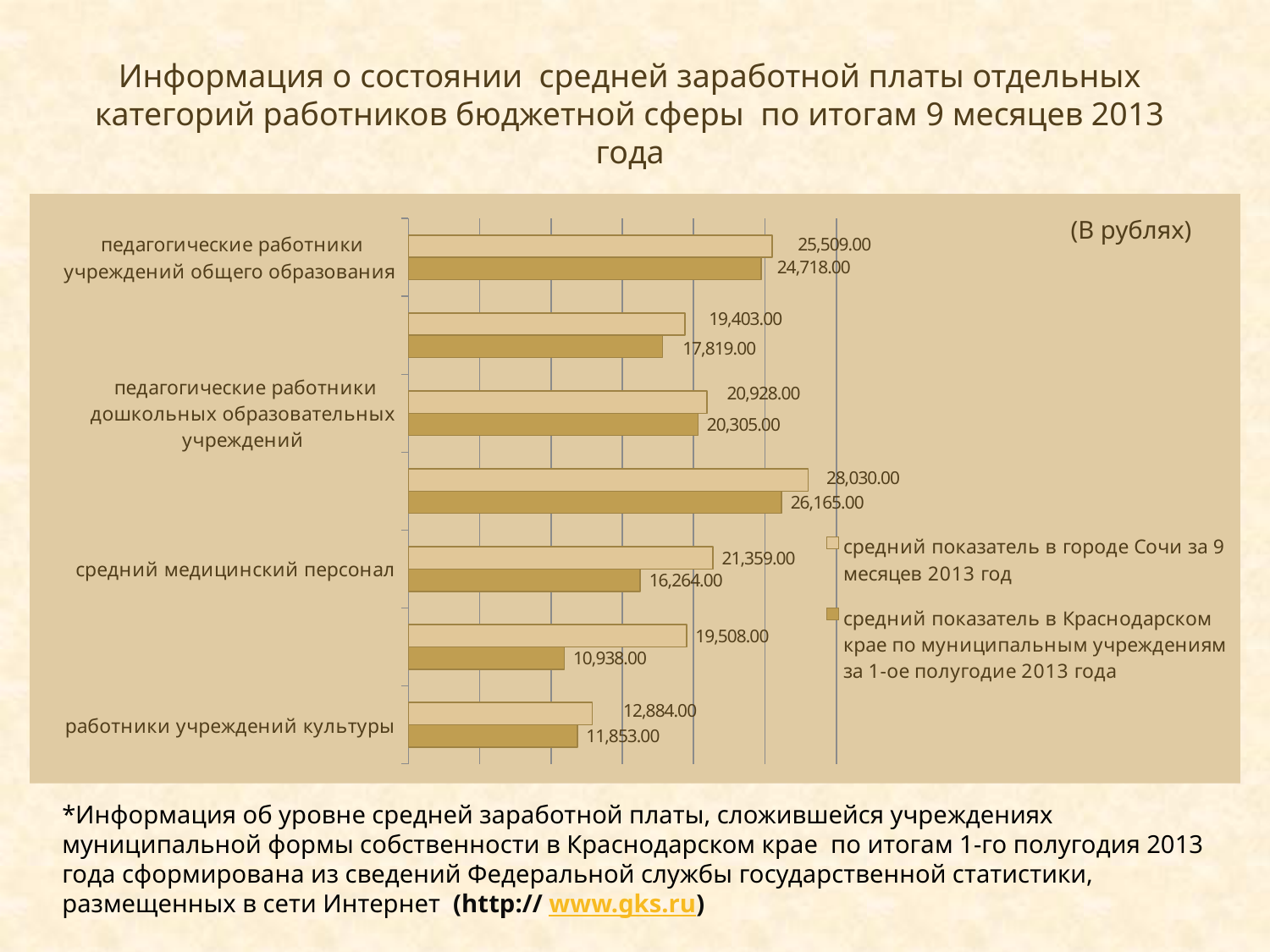
What is the average salary for педагогические работники учреждений общего образования in Sochi for 9 months of 2013? 25,509.00 How many series does the legend list? 2 Which labelled category has the lowest value in the Sochi series? работники учреждений культуры What is the value for педагогические работники дошкольных образовательных учреждений in the Краснодарский край series? 20,305.00 What is the difference between the Sochi and Краснодарский край values for средний медицинский персонал? 5,095.00 Which is larger for средний медицинский персонал: the Sochi value or the Краснодарский край value? the Sochi value In what units are the values on the chart given, according to the note in the top right corner? В рублях What is the value for средний медицинский персонал in the Краснодарский край series? 16,264.00 What is the value for работники учреждений культуры in the Sochi series? 12,884.00 Which has a higher Sochi value: педагогические работники учреждений общего образования or педагогические работники дошкольных образовательных учреждений? педагогические работники учреждений общего образования What is the difference between the Sochi and Краснодарский край values for педагогические работники учреждений общего образования? 791.00 What kind of chart is shown on the slide? bar chart